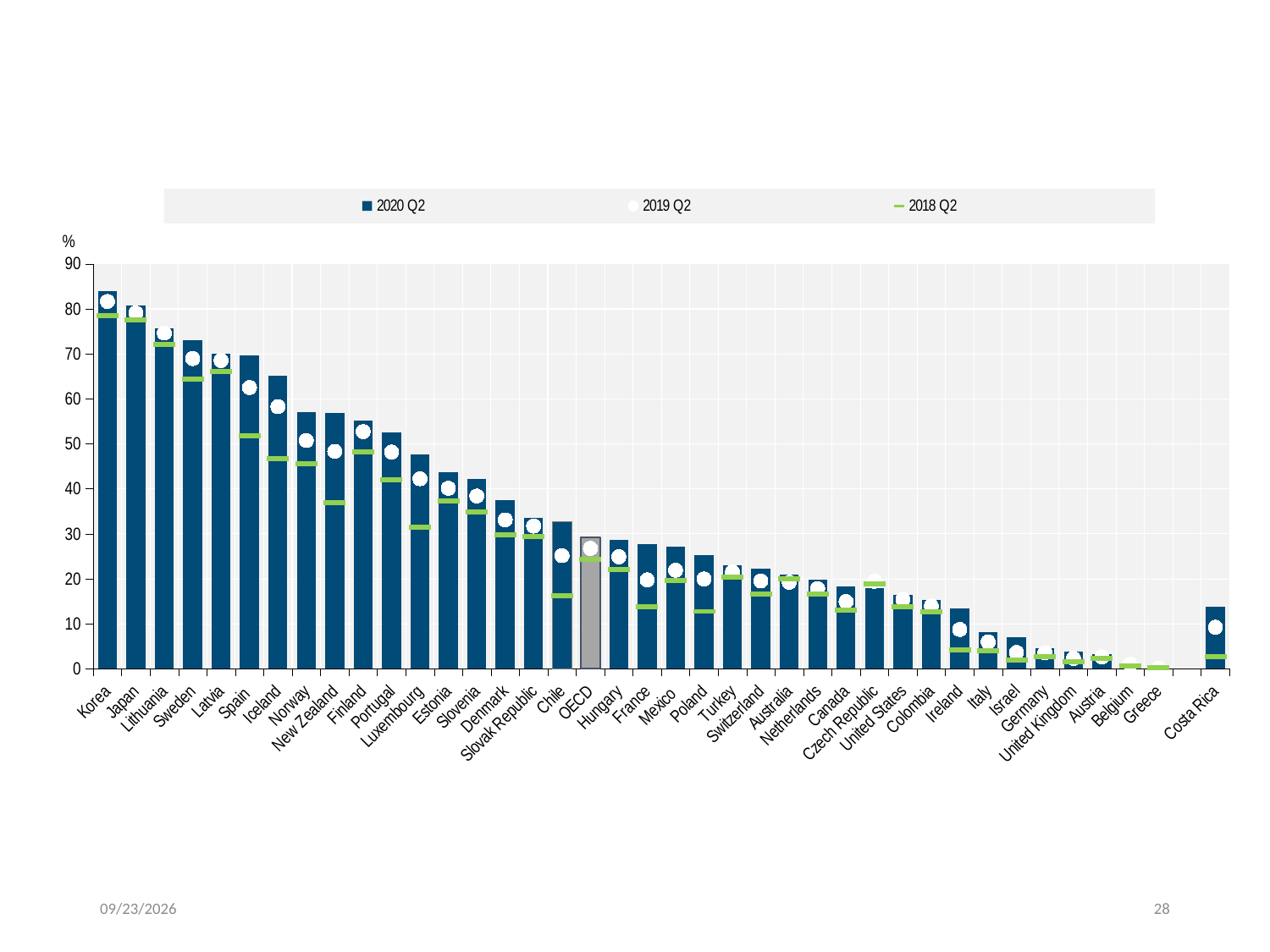
Is the 2020 Q2 value for Italy greater or less than 10? less Do the 2020 Q2 bars generally rise or fall from Korea on the left to Greece on the right? fall How many countries/categories are shown on the x axis? 39 Which category has the highest 2020 Q2 bar? Korea Which has the larger 2020 Q2 bar, Chile or OECD? Chile What kind of chart is shown on the slide? Bar chart How many series does the legend list? 3 Is the 2020 Q2 value for Sweden greater or less than 70? greater Is the 2020 Q2 value for Canada greater or less than 20? less Which series are listed in the legend? 2020 Q2, 2019 Q2, 2018 Q2